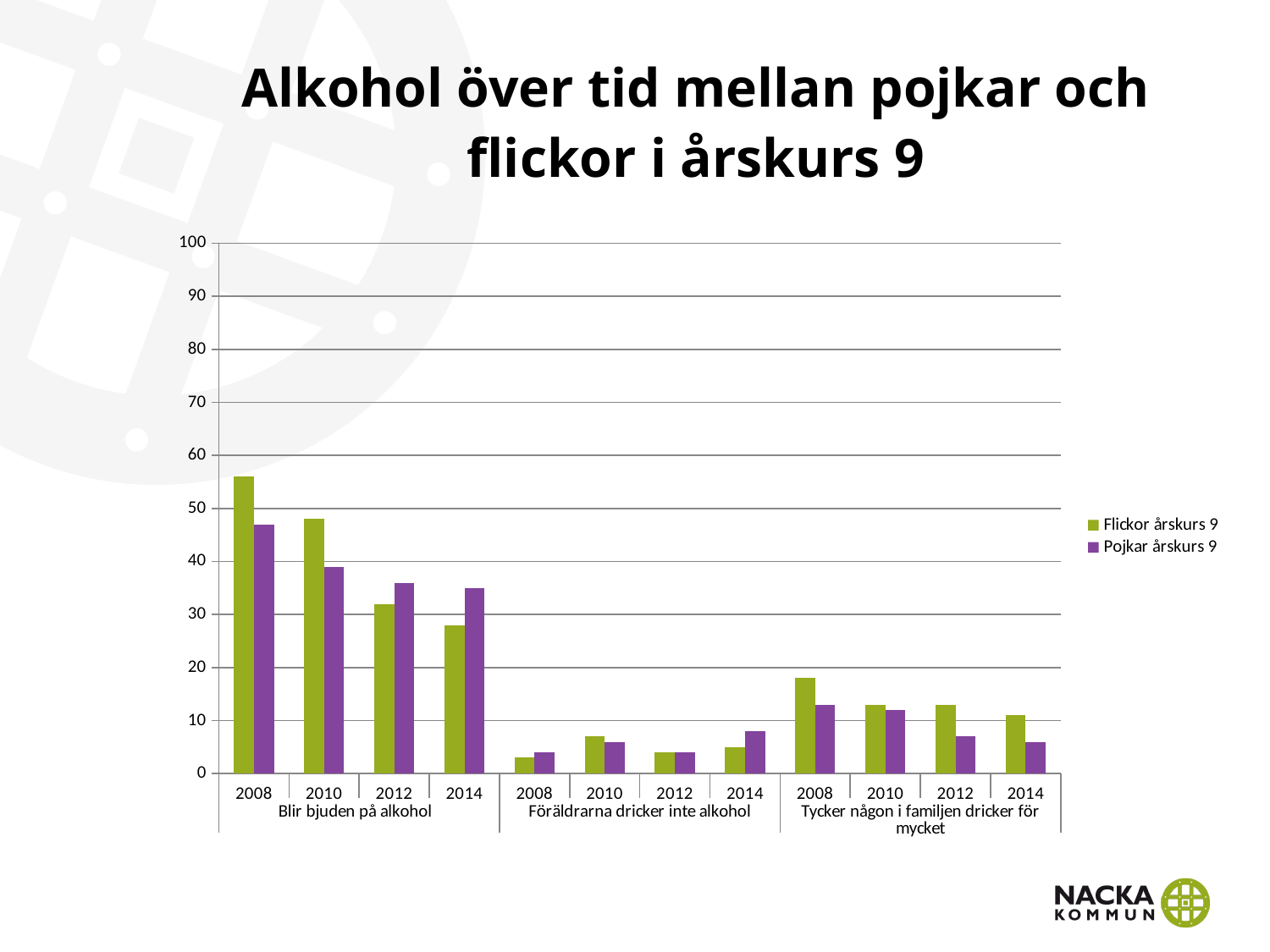
How many year categories are shown within each question group on the x axis? 4 Which series has the higher value in 2012 under 'Tycker någon i familjen dricker för mycket'? Flickor årskurs 9 Which series has the higher value in 2014 under 'Blir bjuden på alkohol'? Pojkar årskurs 9 Is the value for Flickor årskurs 9 in 2008 under 'Tycker någon i familjen dricker för mycket' greater or less than 20? less Which bar is the tallest in the whole chart? Flickor årskurs 9, 2008, Blir bjuden på alkohol What kind of chart is shown on the slide? bar chart Is the value for Flickor årskurs 9 in 2008 under 'Blir bjuden på alkohol' greater or less than 50? greater Do the Flickor årskurs 9 values under 'Blir bjuden på alkohol' rise or fall from 2008 to 2014? fall Is the value for Pojkar årskurs 9 in 2014 under 'Blir bjuden på alkohol' greater or less than 40? less Which two series are listed in the legend? Flickor årskurs 9 and Pojkar årskurs 9 How many series does the legend list? 2 Which series has the higher value in 2008 under 'Blir bjuden på alkohol'? Flickor årskurs 9